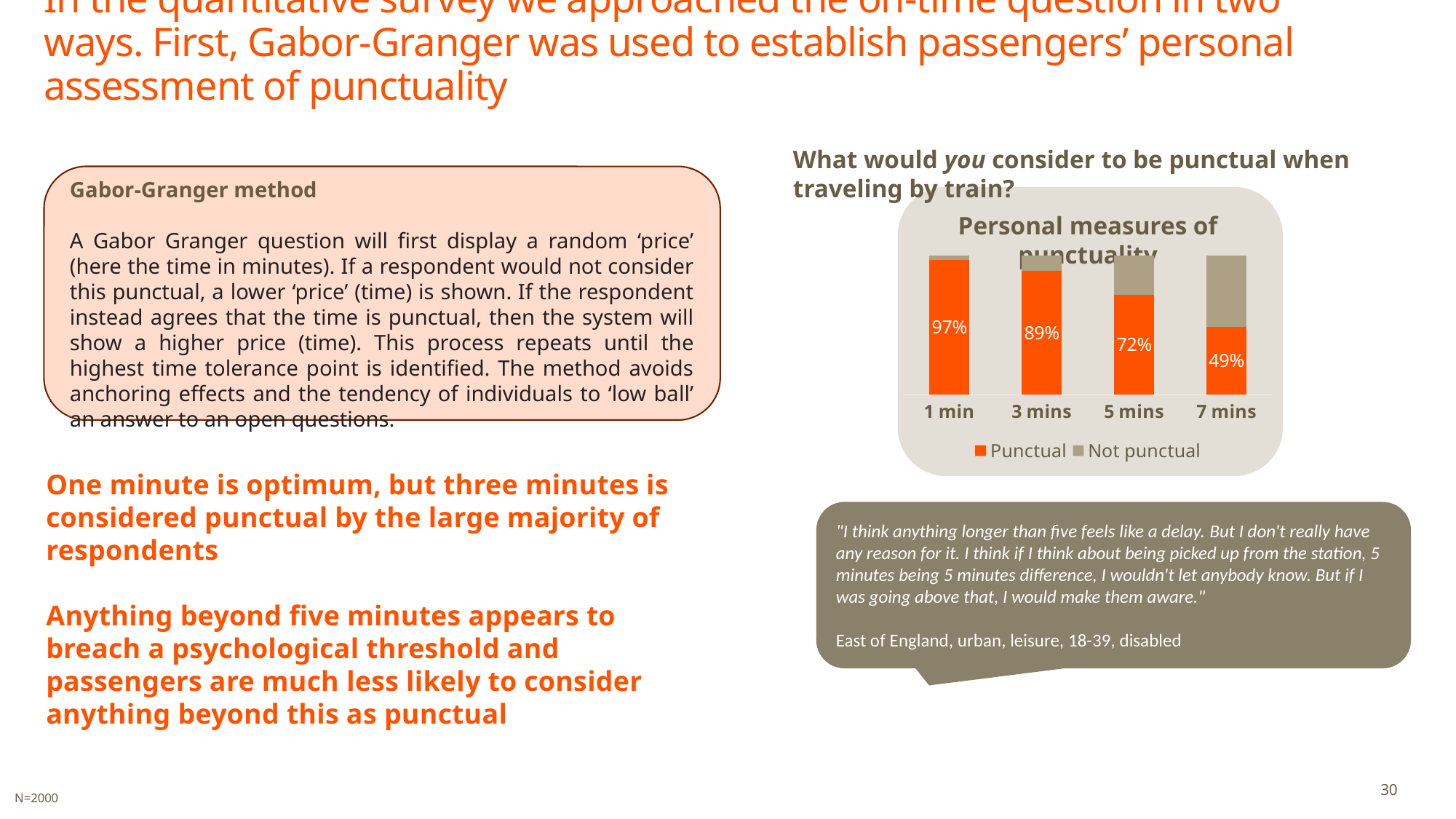
Does the Punctual share rise or fall as the time increases from 1 min to 7 mins? Fall What percentage of respondents consider 1 min to be punctual? 97% How many series does the chart legend list? 2 Which category has the highest Punctual share? 1 min What is the Punctual value for 7 mins? 49% Which has a larger Punctual value, 5 mins or 7 mins? 5 mins What is the Punctual value for 3 mins? 89% How many time categories are shown on the x axis of the chart? 4 What is the difference between the Punctual values for 3 mins and 5 mins? 17% What kind of chart is used to show personal measures of punctuality? Stacked bar chart What is the Punctual value for 5 mins? 72% Which category has the lowest Punctual share? 7 mins